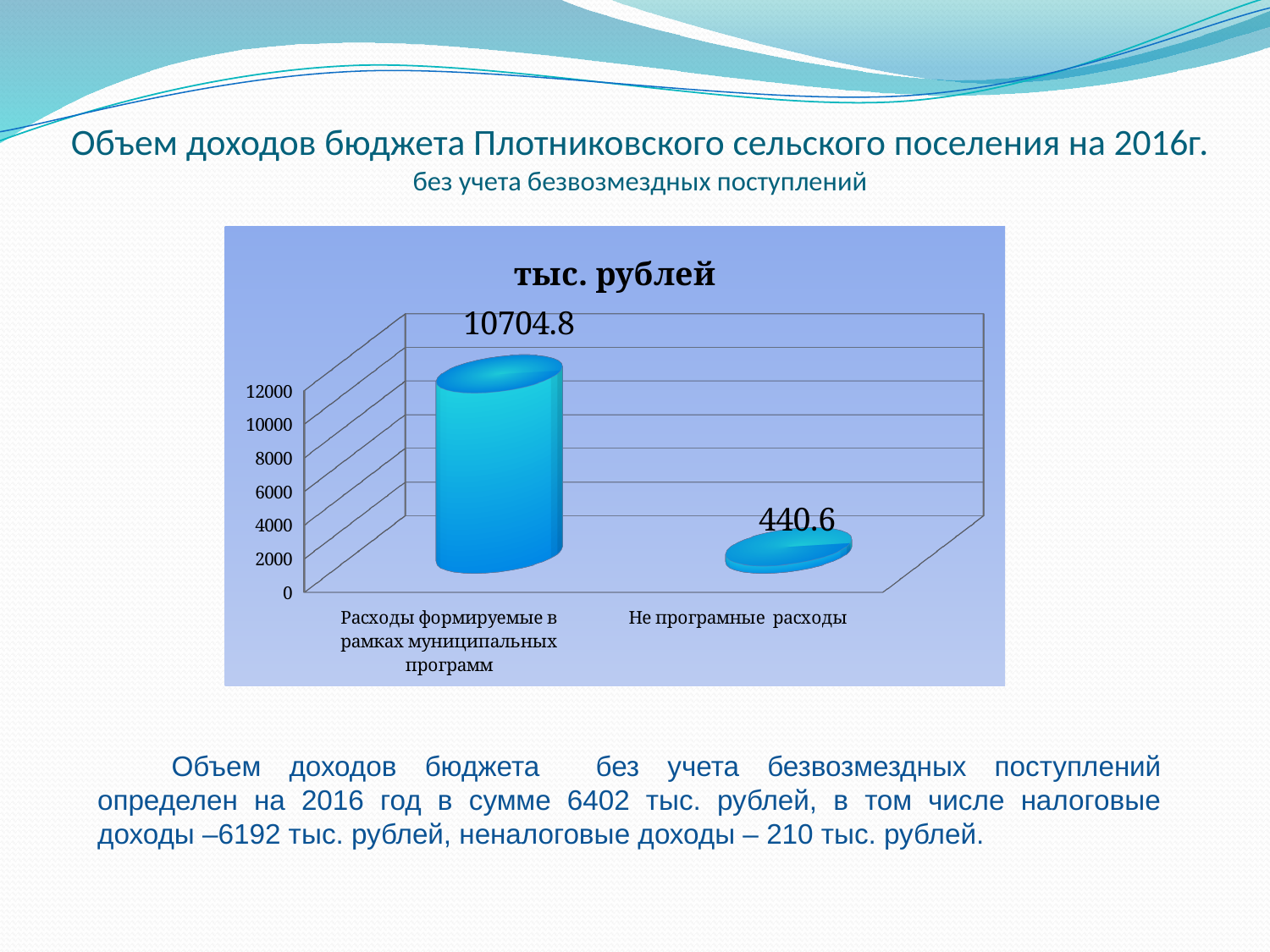
What kind of chart is shown on the slide? bar chart How many categories are shown in the chart? 2 Which is larger: the value for "Расходы формируемые в рамках муниципальных программ" or for "Не програмные расходы"? Расходы формируемые в рамках муниципальных программ What is the highest value shown on the vertical axis of the chart? 12000 What is the value for "Расходы формируемые в рамках муниципальных программ"? 10704.8 What is the value for "Не програмные расходы"? 440.6 What is the difference between the values for "Расходы формируемые в рамках муниципальных программ" and "Не програмные расходы"? 10264.2 Is the value for "Расходы формируемые в рамках муниципальных программ" greater or less than 10000? greater What is the title of the chart? тыс. рублей Is the value for "Не програмные расходы" greater or less than 2000? less Which category has the lowest value? Не програмные расходы Which category has the highest value? Расходы формируемые в рамках муниципальных программ